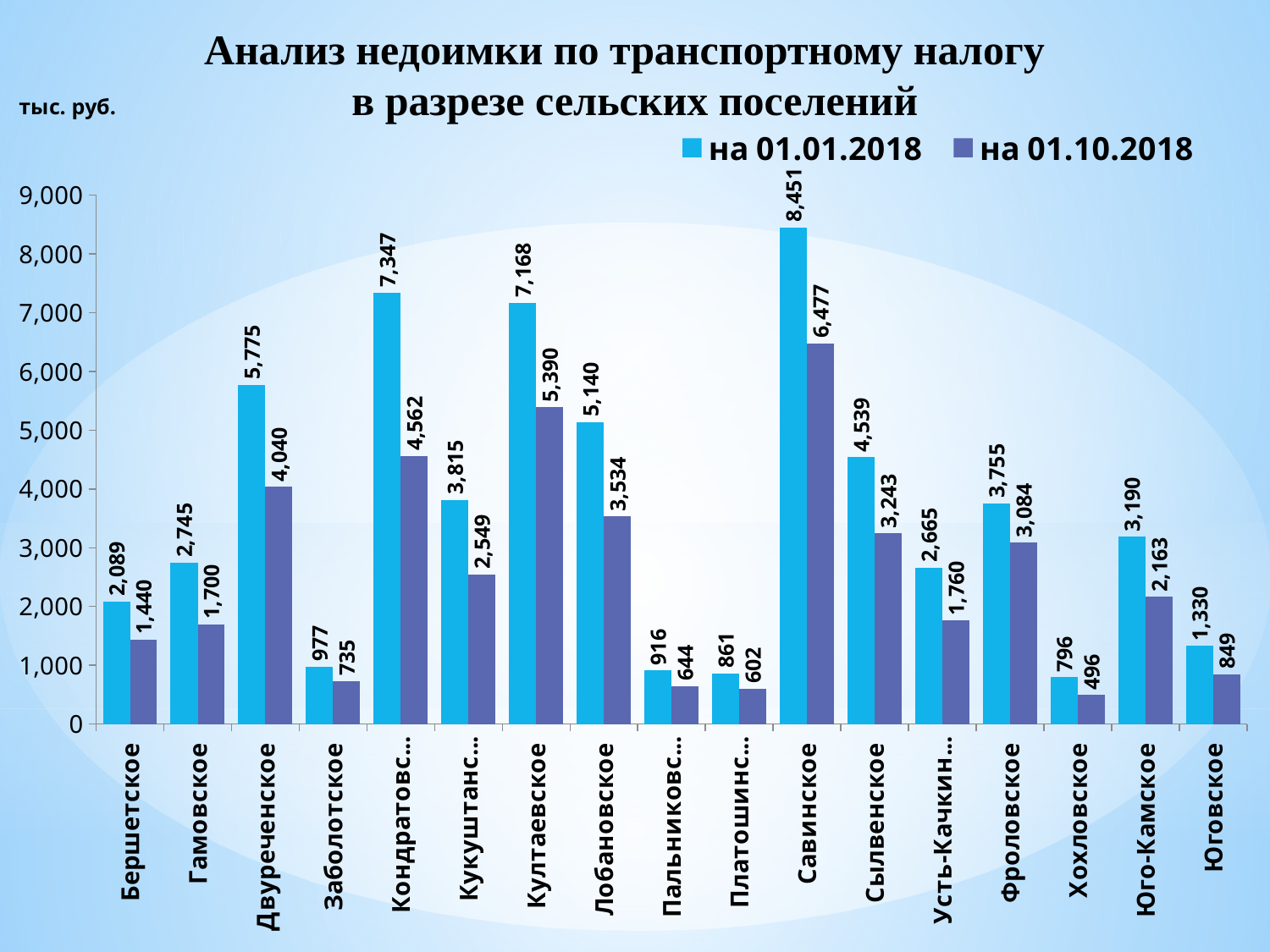
Which settlement has the highest value on 01.01.2018? Савинское What is the value for Двуреченское on 01.10.2018? 4,040 What unit is indicated in the top-left corner of the chart? тыс. руб. What is the value for Хохловское on 01.10.2018? 496 Which is larger: the 01.01.2018 value for Лобановское or the 01.01.2018 value for Сылвенское? Лобановское Which settlement has the lowest value on 01.10.2018? Хохловское How many series does the legend list? 2 How many settlements (categories) are shown on the x axis? 17 What is the value for Савинское on 01.01.2018? 8,451 What is the difference between the 01.01.2018 and 01.10.2018 values for Култаевское? 1,778 What type of chart is shown on the slide? bar chart Is the value for Фроловское on 01.01.2018 greater or less than 3,000? greater